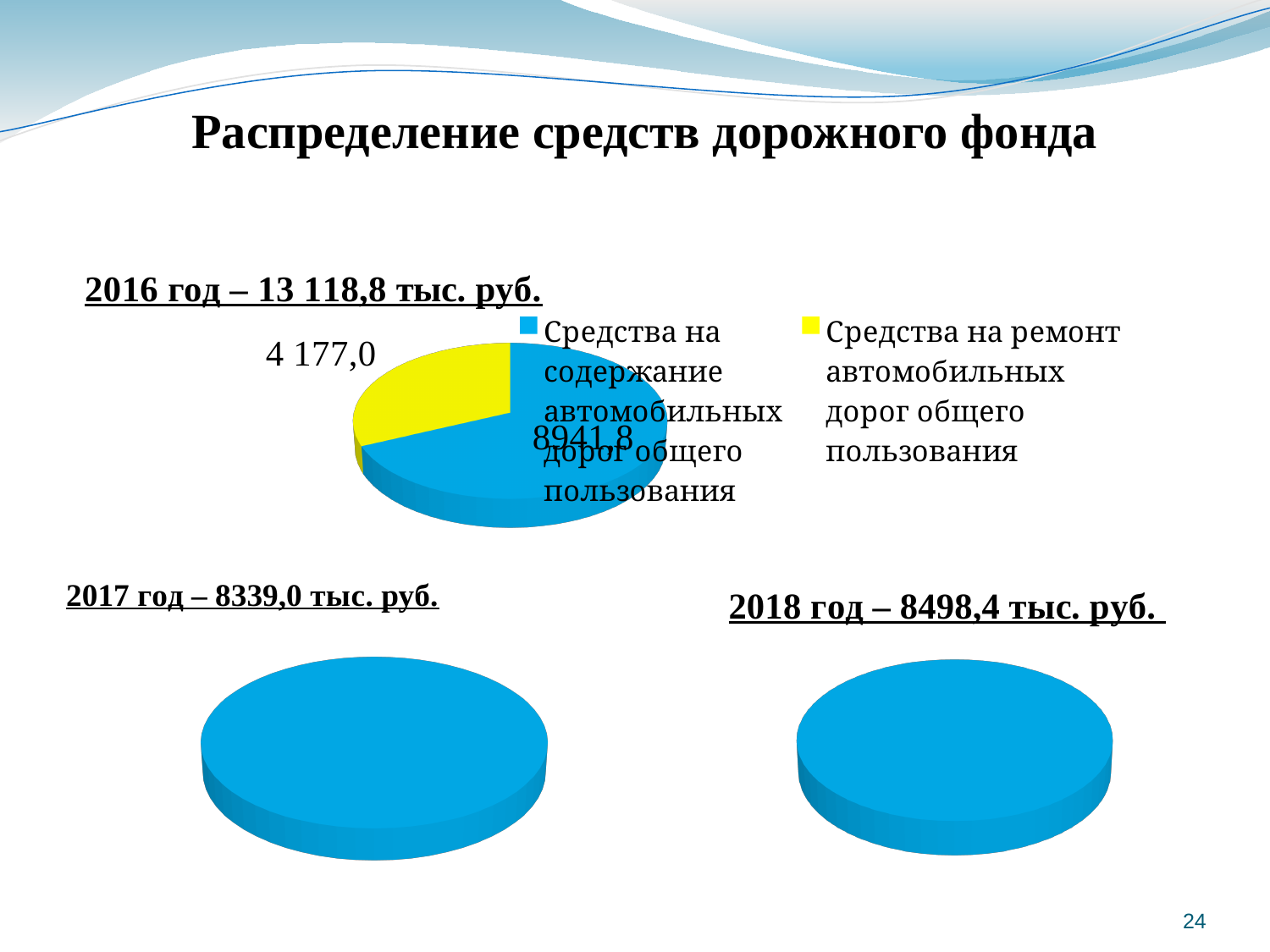
How many slices does the 2016 год pie chart have? 2 In the 2016 год chart, which category has the largest slice? Средства на содержание автомобильных дорог общего пользования In the 2016 год chart, what is the value for Средства на ремонт автомобильных дорог общего пользования? 4 177,0 In the 2016 год chart, what colour is the slice for Средства на ремонт автомобильных дорог общего пользования? yellow In the 2016 год chart, is the value for Средства на содержание larger or smaller than the value for Средства на ремонт? larger In the 2016 год chart, what is the value for Средства на содержание автомобильных дорог общего пользования? 8941,8 What kind of chart is used for the 2016 год data? pie chart In the 2016 год chart, what is the difference between the value for Средства на содержание (8941,8) and the value for Средства на ремонт (4 177,0)? 4764,8 In the 2016 год chart, what is the total of the two slices? 13 118,8 In the 2016 год chart, which category has the smallest slice? Средства на ремонт автомобильных дорог общего пользования How many slices are visible in the 2017 год pie chart? 1 How many entries does the legend of the 2016 год chart list? 2